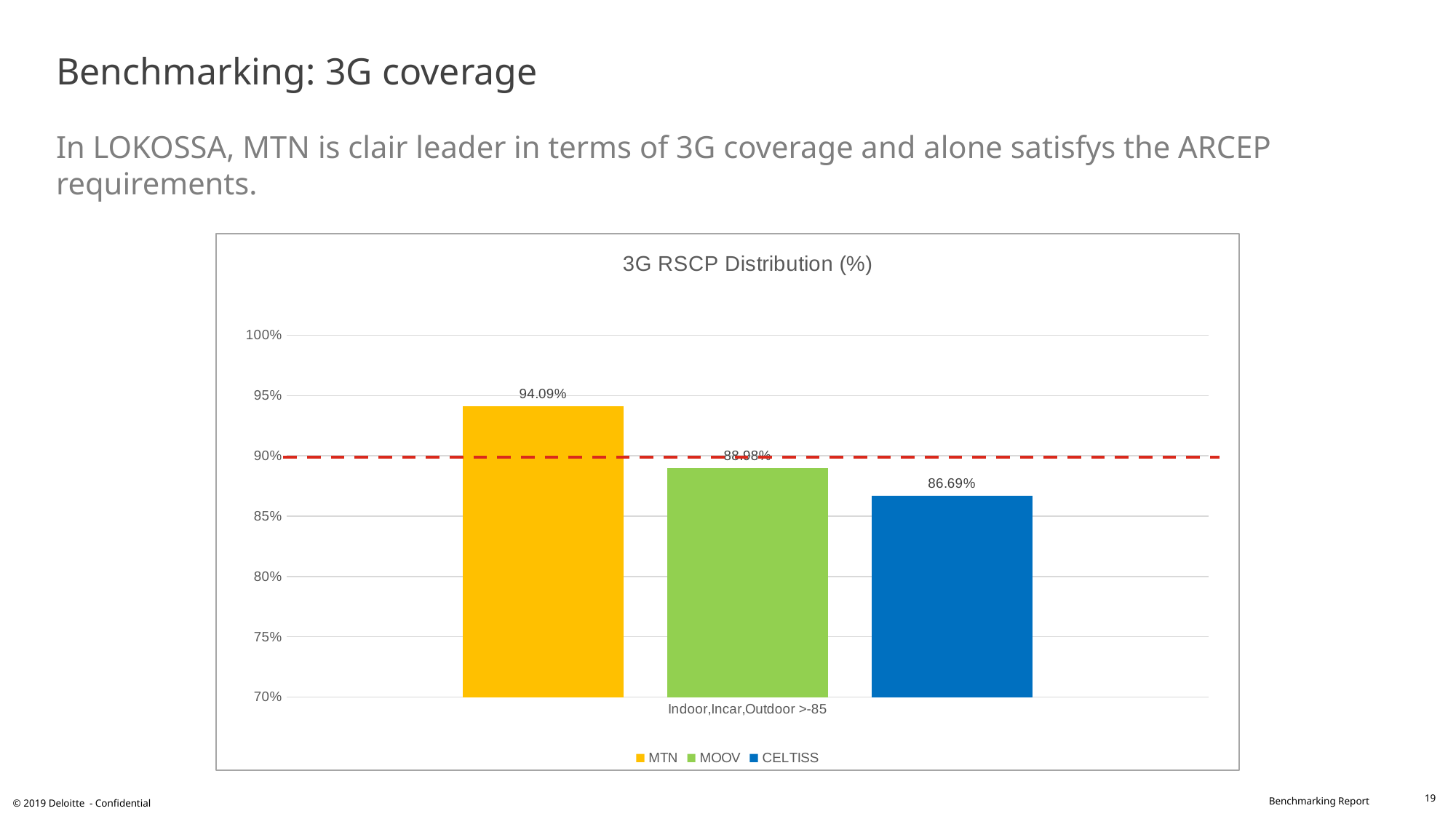
Which operator has the lowest value in the 3G RSCP Distribution (%) chart? CELTISS What is the difference between the MTN and CELTISS values in the 3G RSCP Distribution (%) chart? 7.40% Is the value for MOOV in the 3G RSCP Distribution (%) chart greater or less than 90%? less What is the value for CELTISS in the 3G RSCP Distribution (%) chart? 86.69% Is the value for MTN in the 3G RSCP Distribution (%) chart greater or less than 90%? greater What colour is the MTN bar in the 3G RSCP Distribution (%) chart? yellow How many series does the legend of the 3G RSCP Distribution (%) chart list? 3 What kind of chart is the 3G RSCP Distribution (%) chart? bar chart Which operator has the highest value in the 3G RSCP Distribution (%) chart? MTN What is the value for MTN in the 3G RSCP Distribution (%) chart? 94.09% Which is larger in the 3G RSCP Distribution (%) chart, the value for MOOV or the value for CELTISS? MOOV What is the category label on the x axis of the 3G RSCP Distribution (%) chart? Indoor,Incar,Outdoor >-85